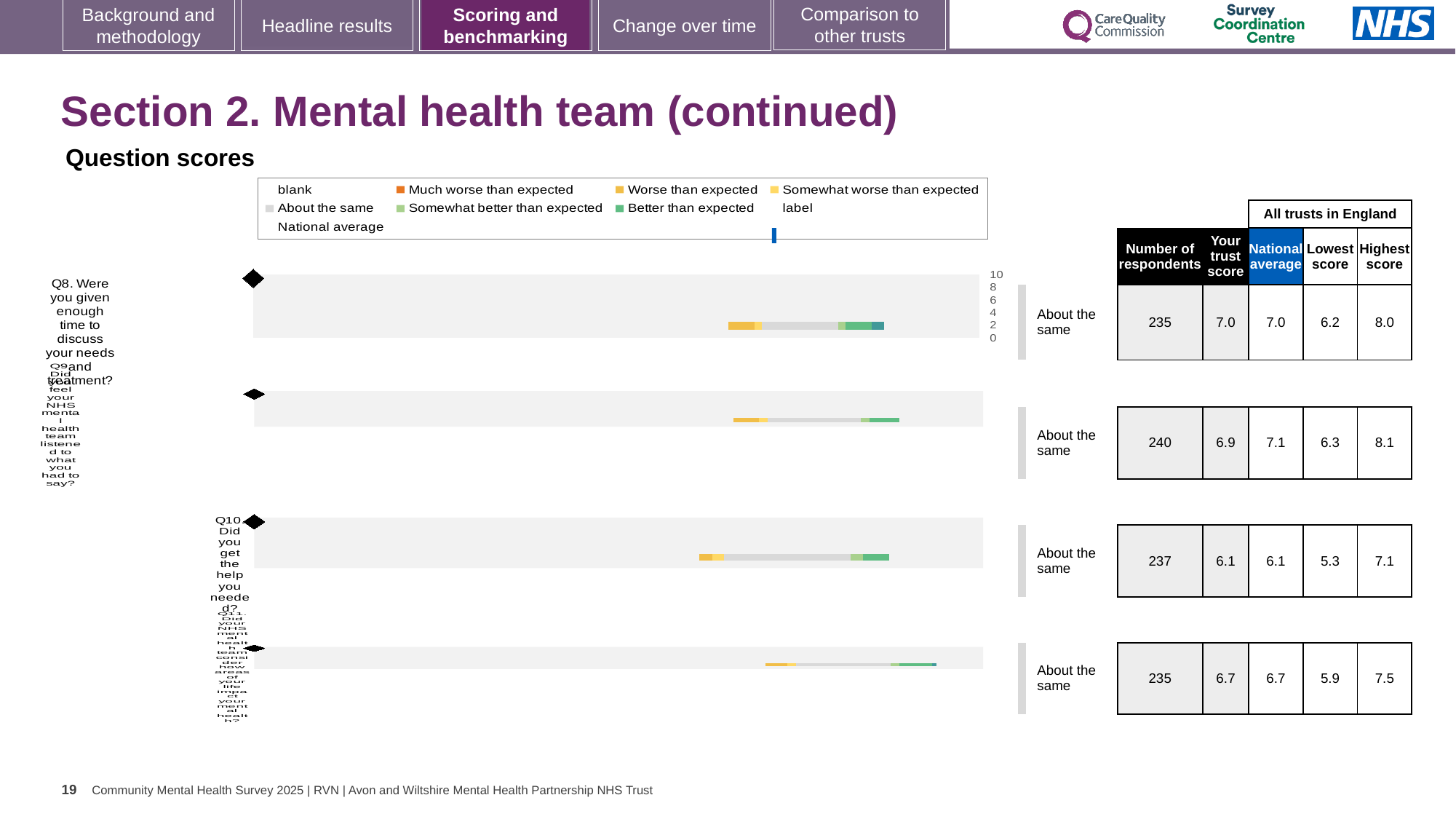
For the Q10 chart, what is the lowest score across all trusts in England shown in the table? 5.3 For Q9, which is larger: the trust score or the national average? National average For the Q8 chart, what is the trust score shown in the table? 7.0 Which question (Q8, Q9, Q10 or Q11) has the highest 'Your trust score' in the table? Q8 In the legend, which colour represents 'Much worse than expected'? orange For the Q9 chart, what is the national average shown in the table? 7.1 For Q9, what is the difference between the highest score and the lowest score in the table? 1.8 For the Q11 chart, how many respondents are shown in the table? 235 Which question (Q8, Q9, Q10 or Q11) has the lowest 'Your trust score' in the table? Q10 What kind of chart is used for each question score on this slide? bar chart What is the maximum value shown on the score axis of the Q8 chart? 10 How many question score charts are shown on the slide? 4